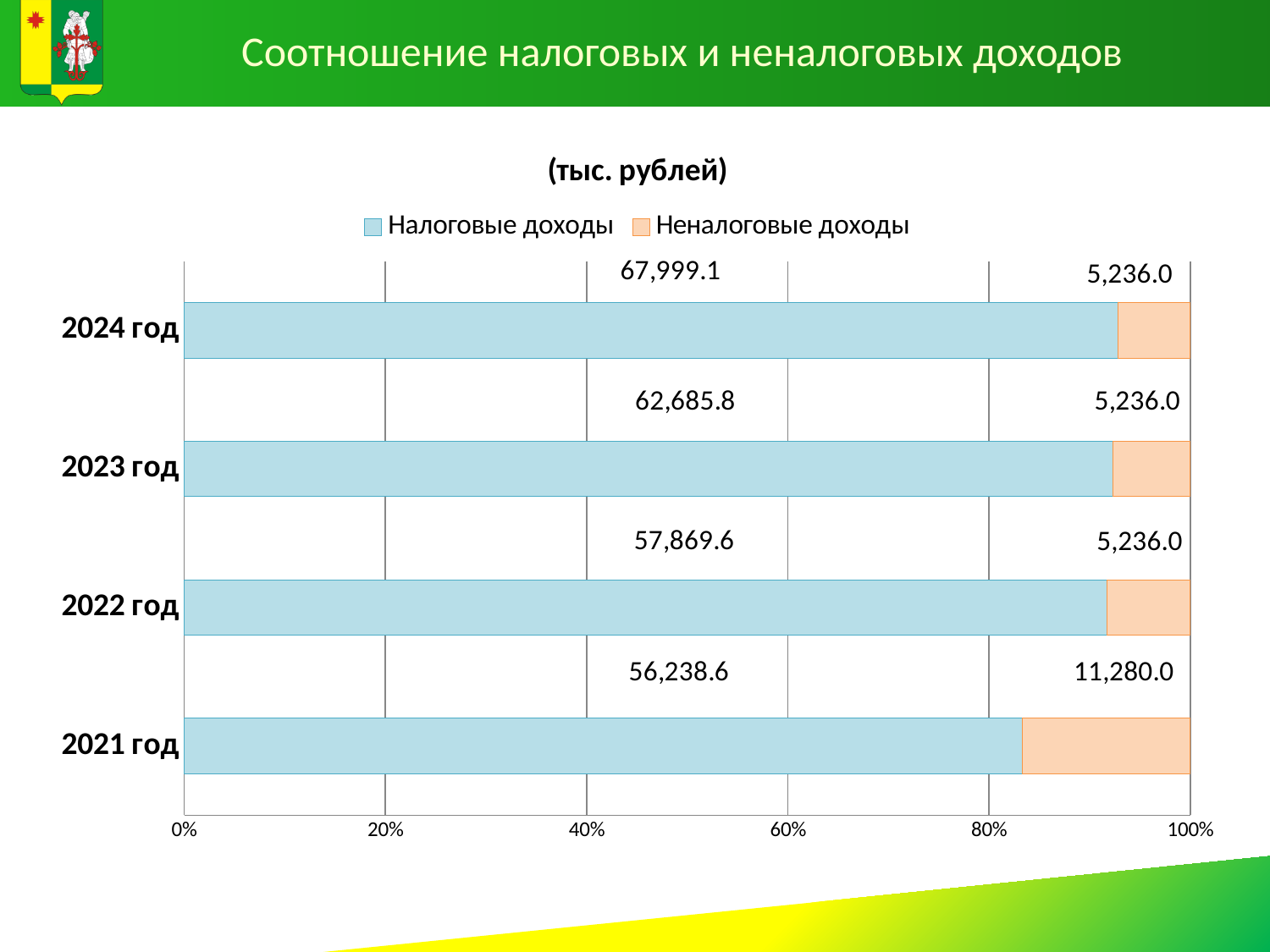
How many series does the legend list? 2 What kind of chart is shown on the slide? Stacked bar chart What is the total of Налоговые доходы and Неналоговые доходы for 2023 год? 67,921.8 What is the value of Неналоговые доходы for 2021 год? 11,280.0 Is the share of Налоговые доходы in 2021 год greater or less than 80%? greater What is the difference between Налоговые доходы in 2024 год and 2023 год? 5,313.3 How many years are shown on the chart? 4 What is the value of Налоговые доходы for 2024 год? 67,999.1 What is the value of Налоговые доходы for 2022 год? 57,869.6 Which year has the highest value of Налоговые доходы? 2024 год Which year has the lowest value of Налоговые доходы? 2021 год Which is larger: Неналоговые доходы in 2021 год or in 2022 год? 2021 год